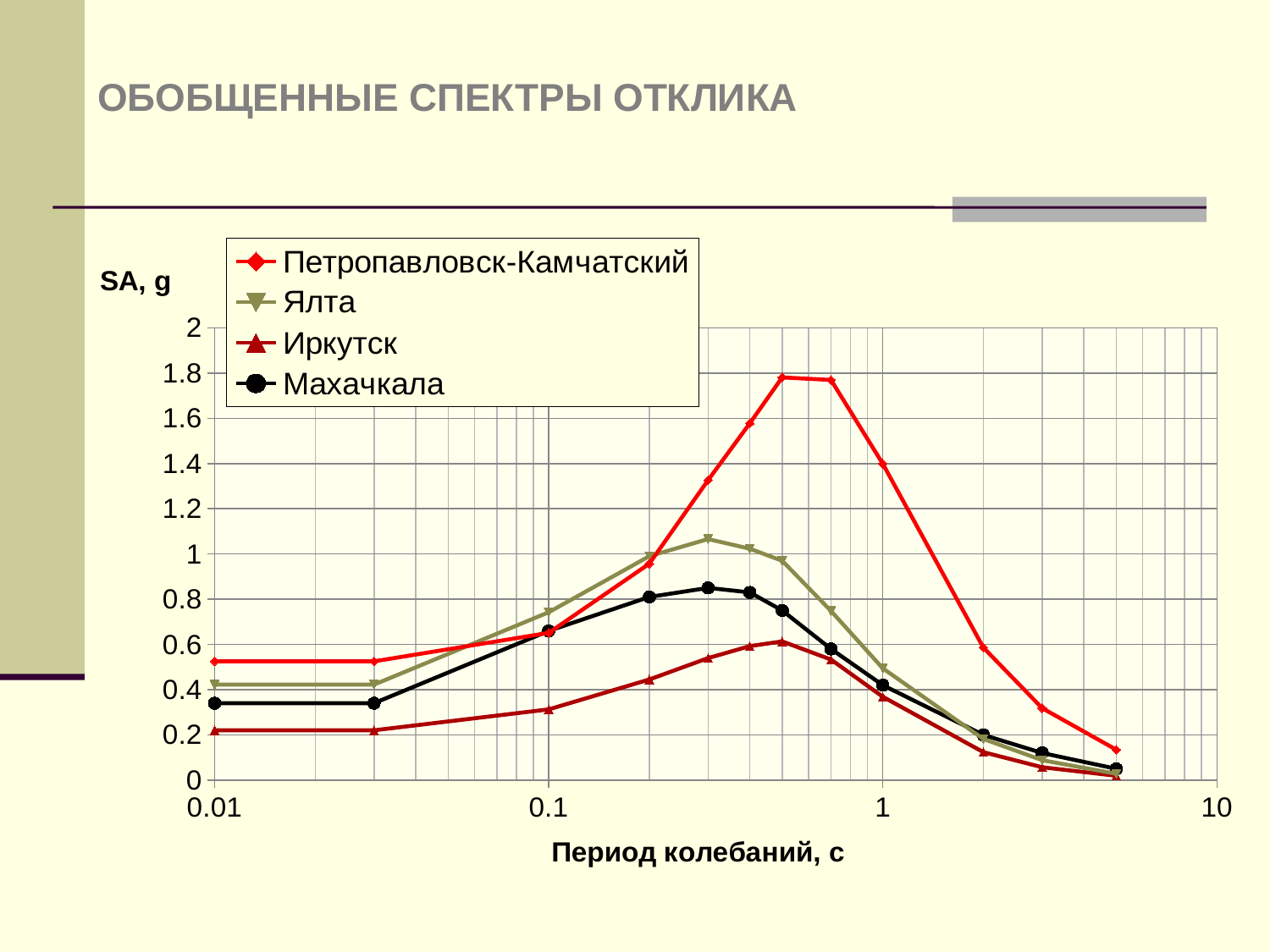
Is the peak value for Махачкала greater or less than 1? less Between periods of 1 s and 10 s, do the values for Петропавловск-Камчатский rise or fall? fall Which series reaches the highest peak value? Петропавловск-Камчатский What is the label on the vertical axis of the chart? SA, g Is the value for Иркутск at a period of 0.01 s greater or less than 0.4? less Which series has the lowest peak value? Иркутск Is the peak value for Петропавловск-Камчатский greater or less than 1.6? greater How many series does the legend list? 4 What kind of chart is shown on the slide? line chart What is the title of the horizontal axis? Период колебаний, с At a period of 0.01 s, which series has the higher value, Петропавловск-Камчатский or Махачкала? Петропавловск-Камчатский